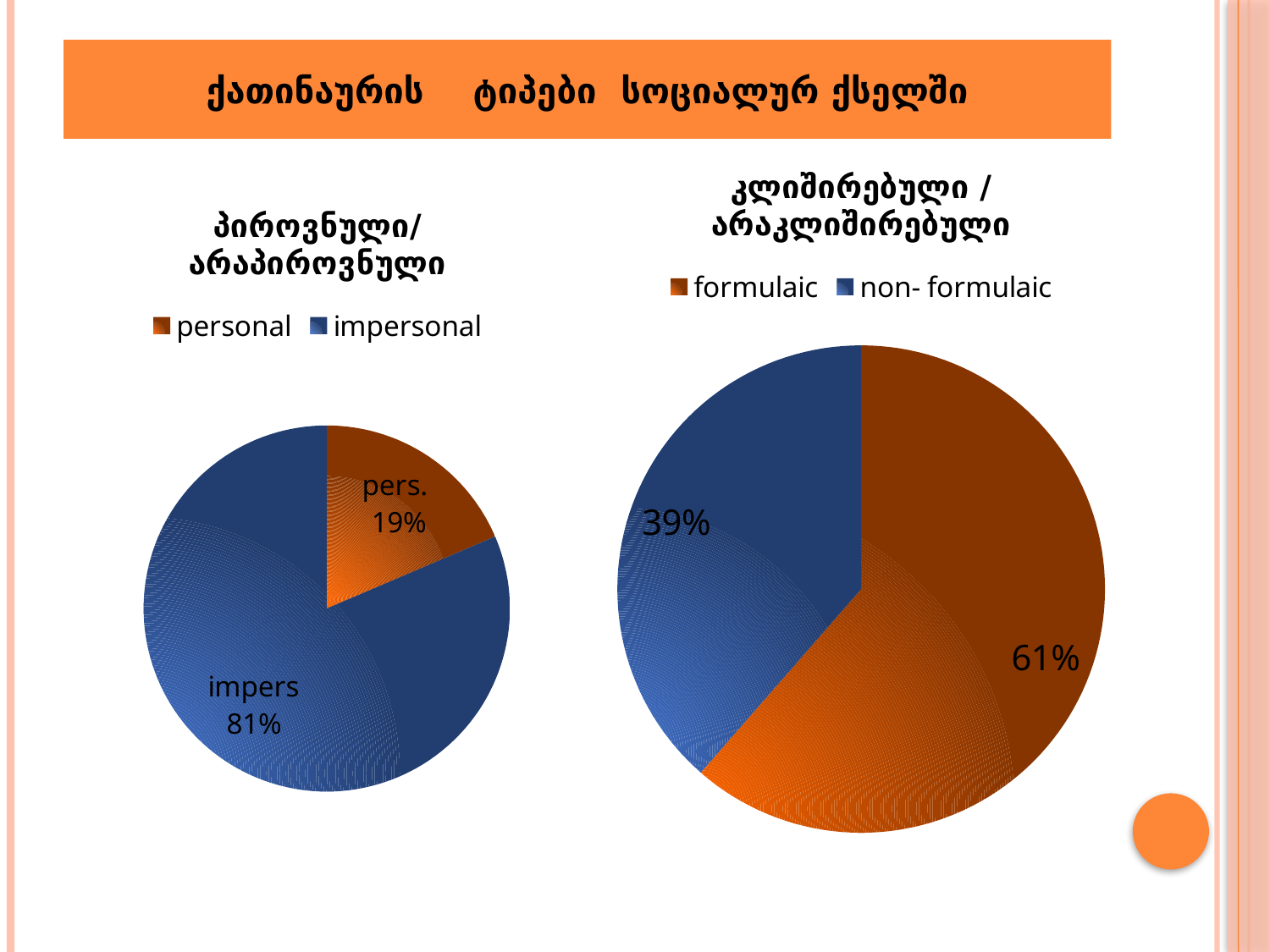
In the right pie chart, what is the difference in percentage points between the formulaic and non-formulaic slices? 22 In the right pie chart, which is larger: formulaic or non-formulaic? formulaic What type of chart is the right chart on the slide? pie chart How many entries does the legend of the right chart list? 2 In the left pie chart, what share is labelled for the personal (pers.) slice? 19% In the right pie chart, what percentage is shown for the formulaic slice? 61% In the right pie chart, which slice is the smallest? non-formulaic In the left pie chart, what is the difference in percentage points between the impersonal and personal slices? 62 In the left pie chart, which slice is the largest? impersonal In the left pie chart, what share is labelled for the impersonal (impers) slice? 81% In the right pie chart, what percentage is shown for the non-formulaic slice? 39% How many slices does the left pie chart have? 2